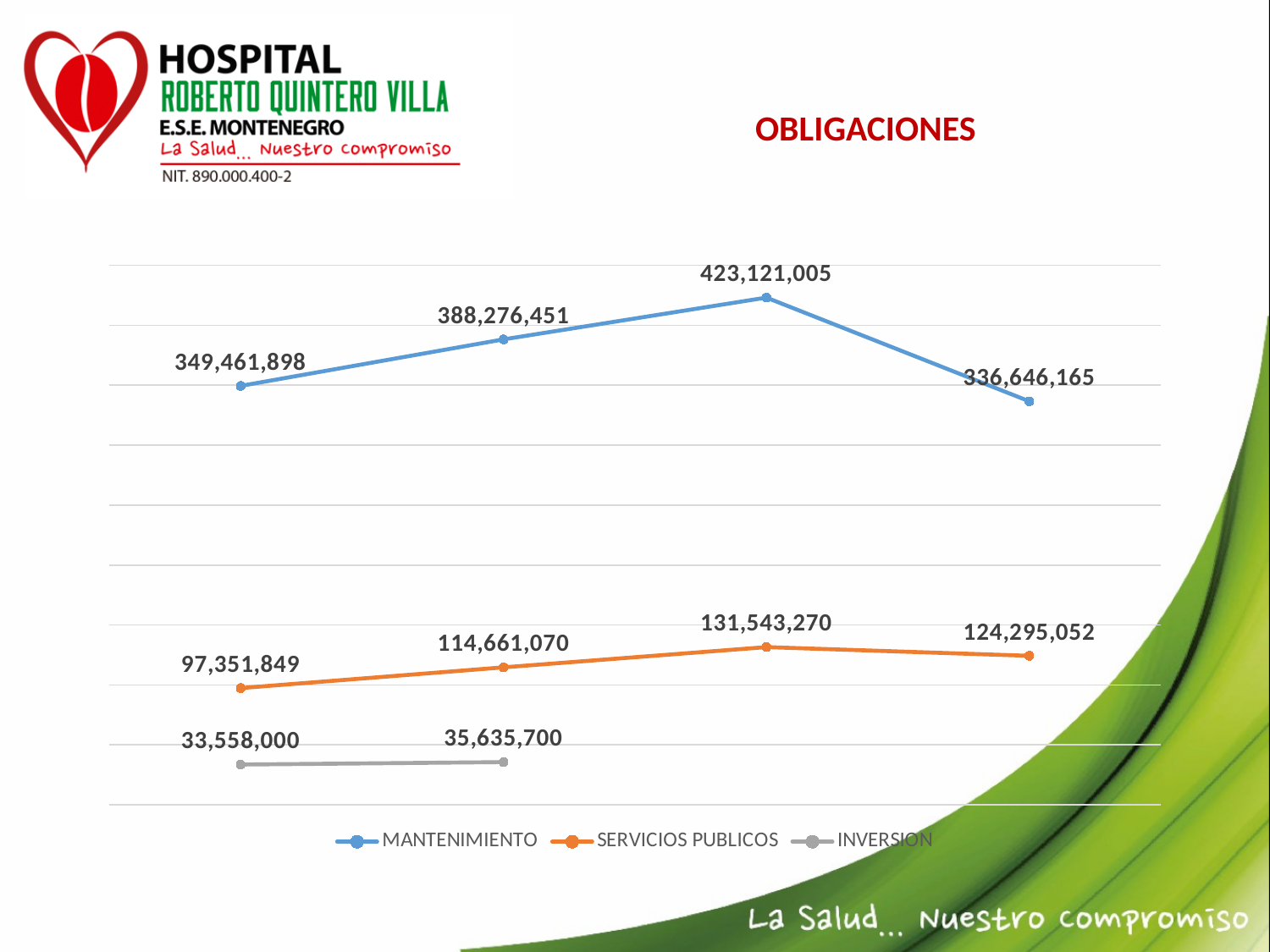
What is the last value plotted for SERVICIOS PUBLICOS? 124,295,052 What is the second value plotted for INVERSION? 35,635,700 What is the lowest value plotted for MANTENIMIENTO? 336,646,165 What kind of chart is shown on the slide? line chart What is the first value plotted for SERVICIOS PUBLICOS? 97,351,849 Which is larger for SERVICIOS PUBLICOS, the third value or the fourth value? the third value (131,543,270) What is the difference between the third and fourth MANTENIMIENTO values? 86,474,840 What is the highest value plotted for MANTENIMIENTO? 423,121,005 What is the title of the chart? OBLIGACIONES How many data points are plotted for INVERSION? 2 How many series does the legend list? 3 What is the difference between the two INVERSION values? 2,077,700